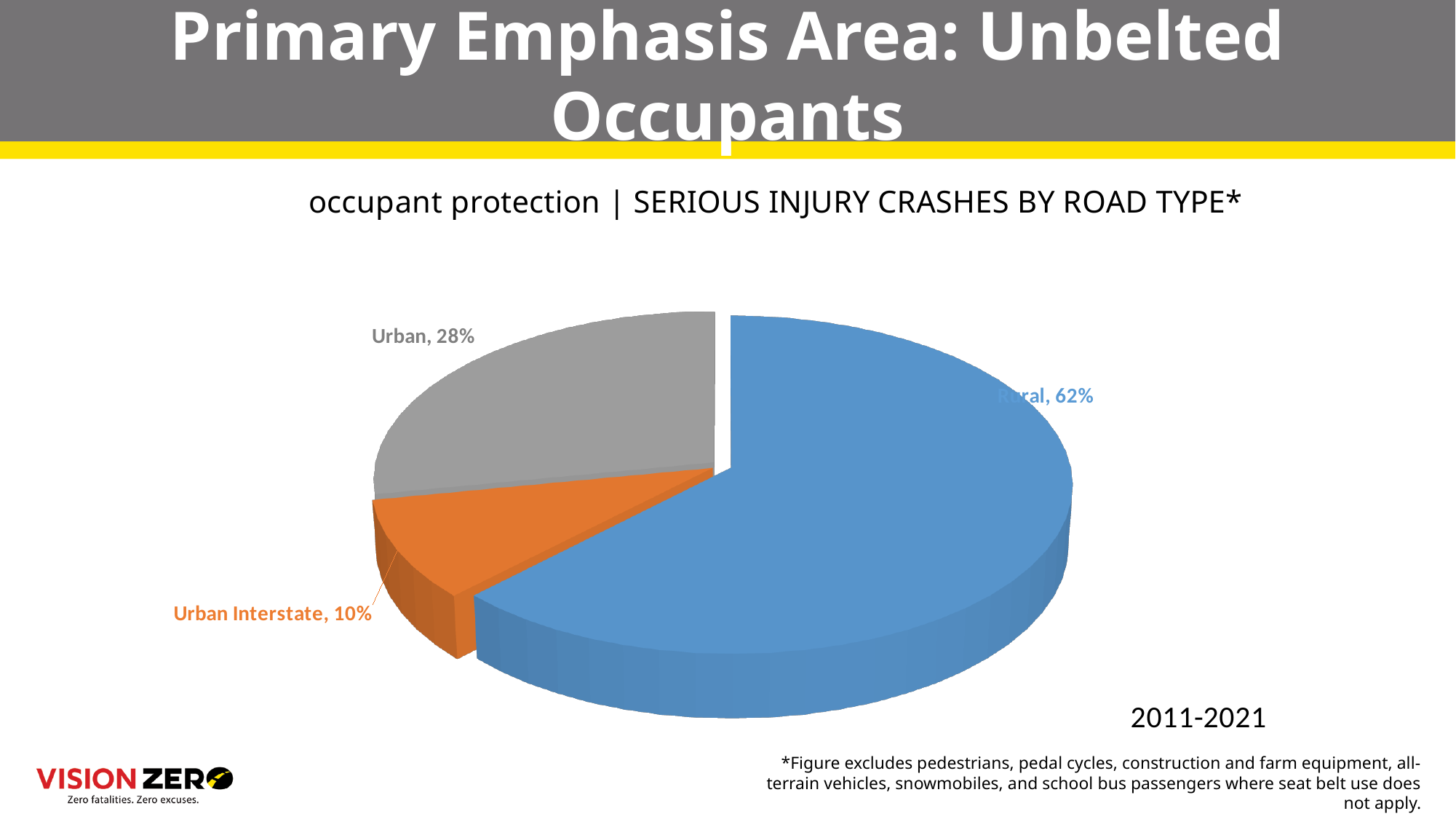
What kind of chart is shown on the slide? Pie chart What share of serious injury crashes occurred on Urban roads? 28% Which has a larger share, Urban or Urban Interstate? Urban What is the difference in percentage points between the Urban and Urban Interstate shares? 18 What colour is the Urban Interstate slice? Orange How many road type categories are shown in the pie chart? 3 What is the difference in percentage points between the Rural and Urban shares? 34 Which road type has the largest share of serious injury crashes? Rural What share of serious injury crashes occurred on Urban Interstate roads? 10% What share of serious injury crashes occurred on Rural roads? 62% What is the title of the chart? occupant protection | SERIOUS INJURY CRASHES BY ROAD TYPE* Which road type has the smallest share of serious injury crashes? Urban Interstate